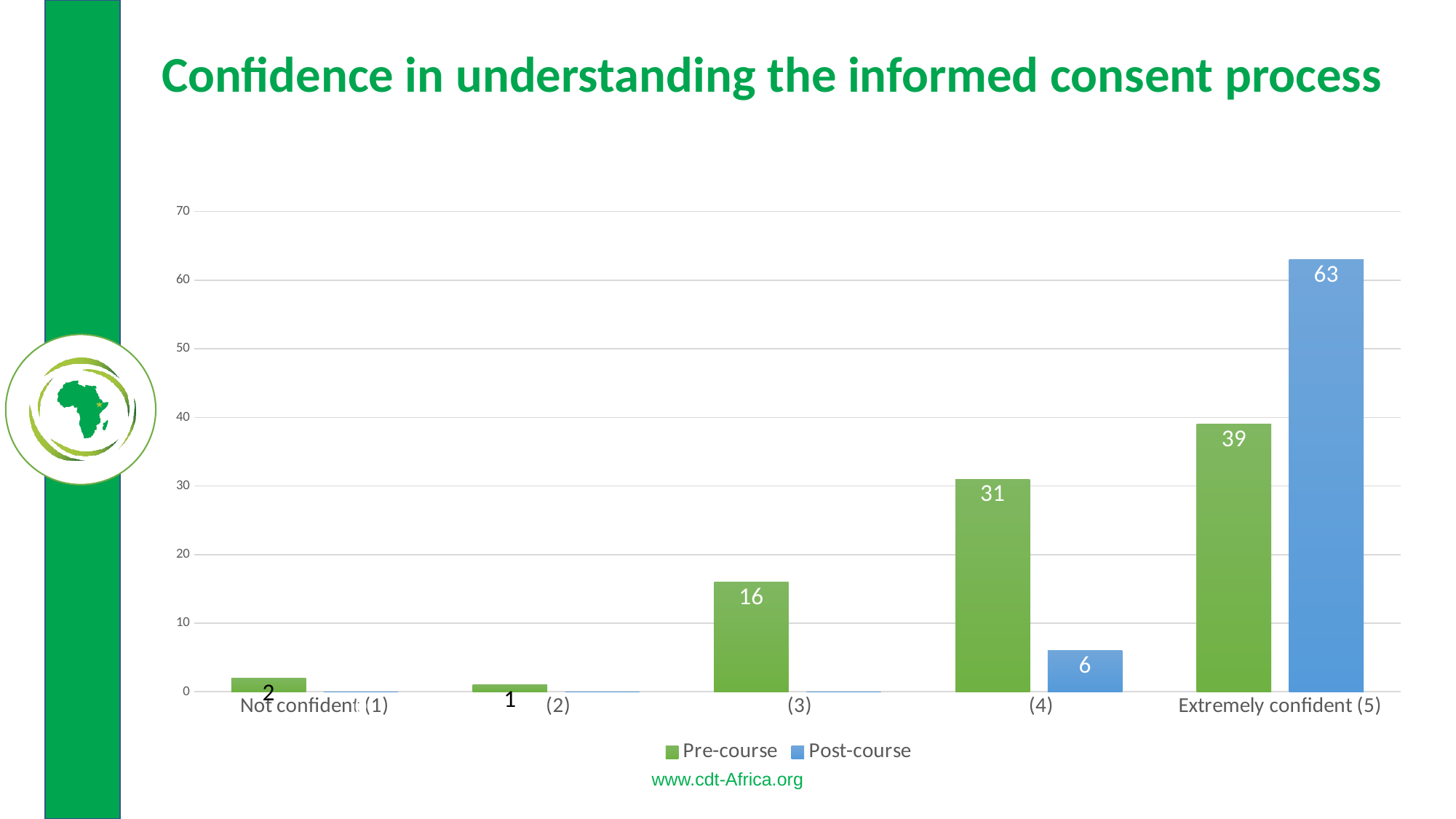
Which category has the lowest Pre-course value? (2) How many series does the legend list? 2 For Extremely confident (5), how much higher is the Post-course value than the Pre-course value? 24 What is the Pre-course value for category (4)? 31 Which category has the highest Pre-course value? Extremely confident (5) For category (4), which series has the larger value, Pre-course or Post-course? Pre-course What is the Post-course value for Extremely confident (5)? 63 Is the Post-course value for Extremely confident (5) greater or less than 60? greater What kind of chart is shown on the slide? bar chart How many categories are shown on the x axis? 5 For category (4), what is the difference between the Pre-course and Post-course values? 25 What is the Pre-course value for category (3)? 16